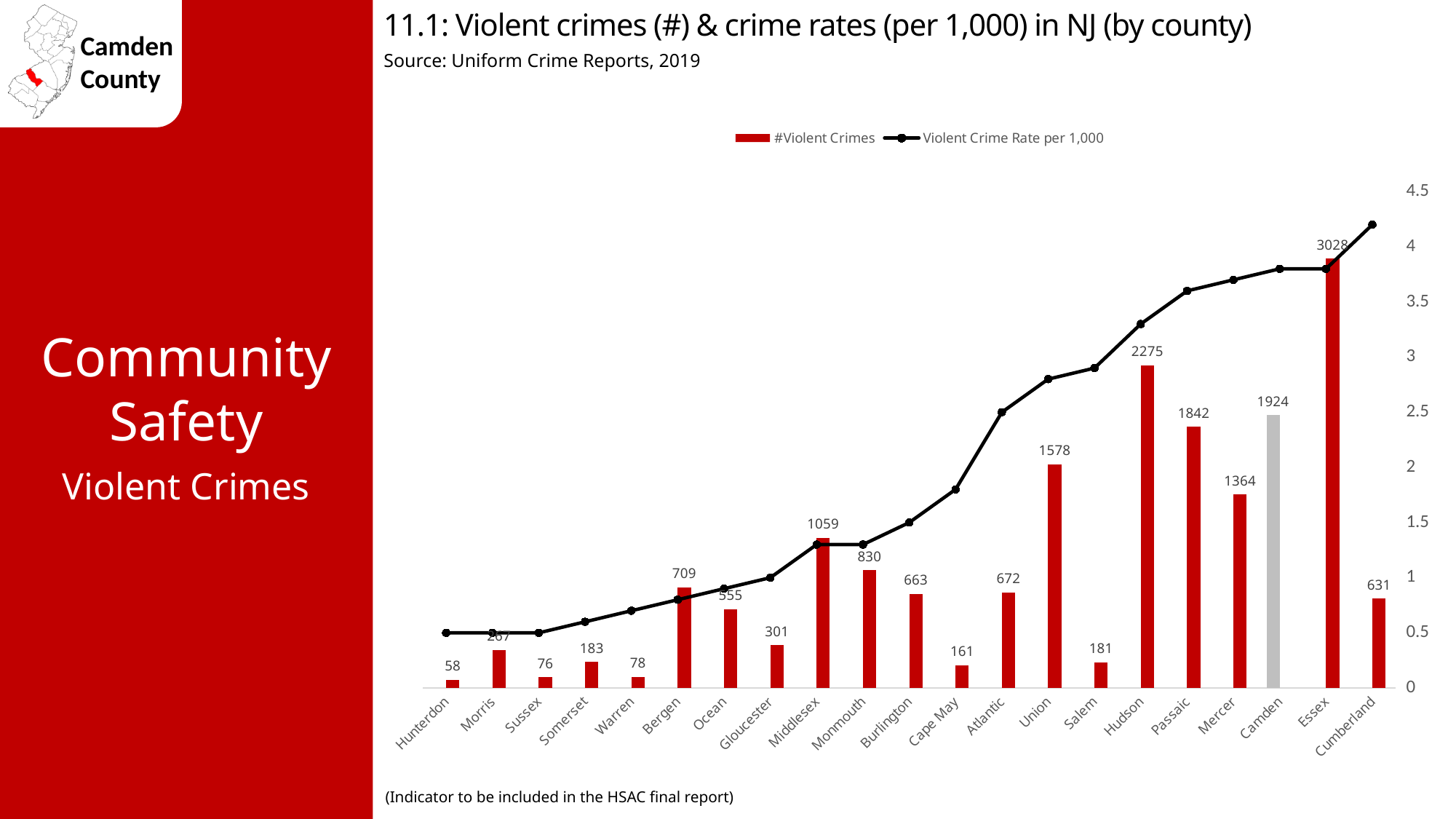
How many counties are shown on the x axis? 21 Does the violent crime rate per 1,000 line generally rise or fall from Hunterdon to Cumberland? Rise How many series does the legend list? 2 Is the violent crime rate per 1,000 for Cumberland greater or less than 4? greater Which county has more violent crimes, Hudson or Passaic? Hudson What kind of chart is this? Combined bar and line chart Is the violent crime rate per 1,000 for Hunterdon greater or less than 1? less What is the difference in the number of violent crimes between Essex and Camden? 1104 Which county has the highest number of violent crimes? Essex How many violent crimes are shown for Camden county? 1924 Which county has the lowest number of violent crimes? Hunterdon What is the number of violent crimes for Essex county? 3028